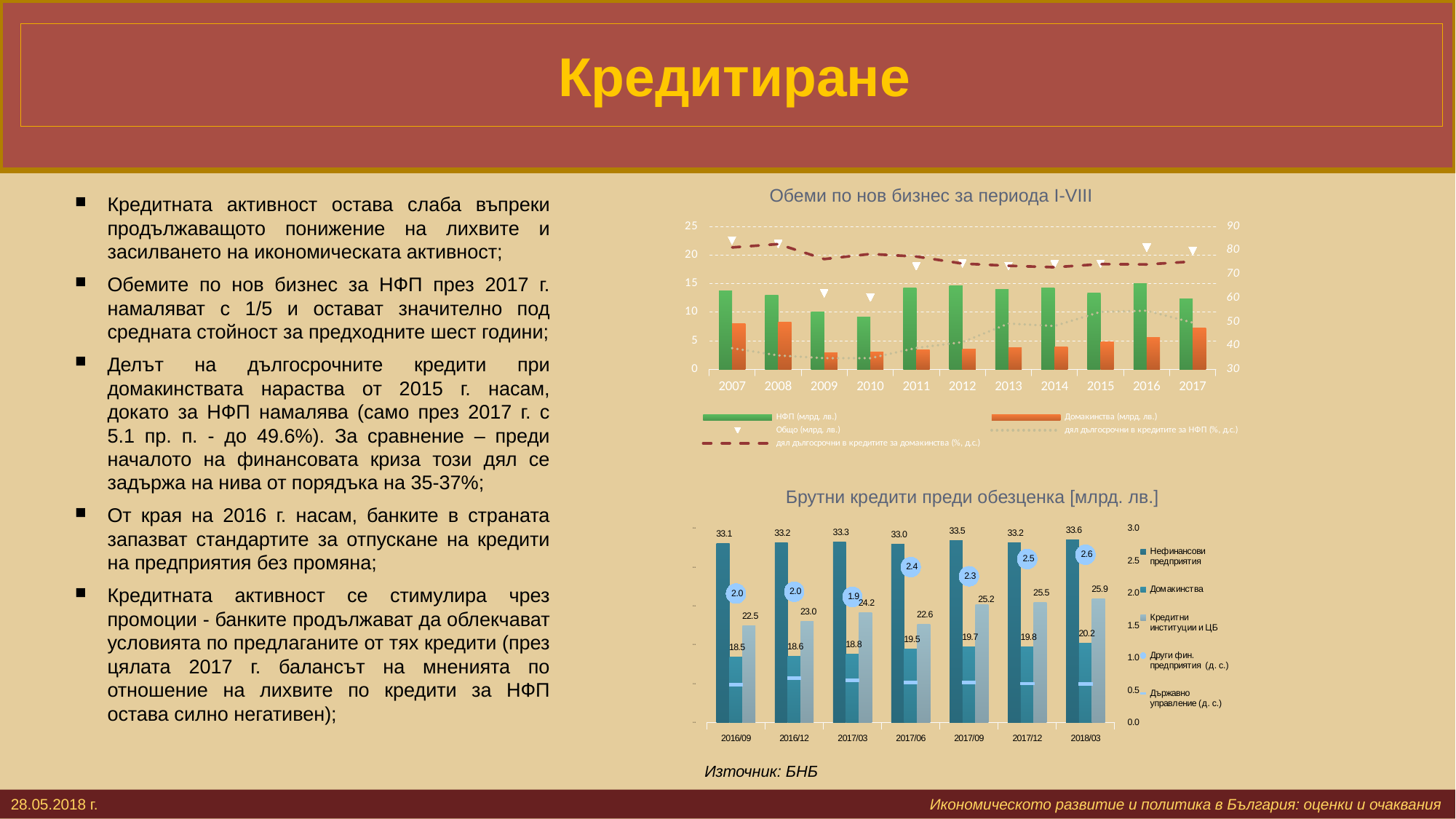
In the chart 'Брутни кредити преди обезценка [млрд. лв.]', which is larger for Кредитни институции и ЦБ: 2017/03 or 2017/06? 2017/03 In the chart 'Брутни кредити преди обезценка [млрд. лв.]', in which period is the value for Домакинства highest? 2018/03 In the chart 'Брутни кредити преди обезценка [млрд. лв.]', what is the value for Домакинства in 2016/09? 18.5 In the chart 'Брутни кредити преди обезценка [млрд. лв.]', do the values for Домакинства rise or fall from 2016/09 to 2018/03? rise In the chart 'Брутни кредити преди обезценка [млрд. лв.]', what is the value for Други фин. предприятия in 2017/06? 2.4 In the chart 'Брутни кредити преди обезценка [млрд. лв.]', by how much does the value for Домакинства in 2018/03 exceed the value in 2016/09? 1.7 In the chart 'Брутни кредити преди обезценка [млрд. лв.]', in which period is the value for Кредитни институции и ЦБ lowest? 2016/09 In the chart 'Брутни кредити преди обезценка [млрд. лв.]', what is the value for Кредитни институции и ЦБ in 2017/09? 25.2 In the chart 'Обеми по нов бизнес за периода I-VIII', is the value for НФП (млрд. лв.) in 2016 greater or less than 10? greater How many periods are shown on the x axis of the chart 'Брутни кредити преди обезценка [млрд. лв.]'? 7 In the chart 'Брутни кредити преди обезценка [млрд. лв.]', what is the value for Нефинансови предприятия in 2018/03? 33.6 How many series does the legend of the chart 'Обеми по нов бизнес за периода I-VIII' list? 5